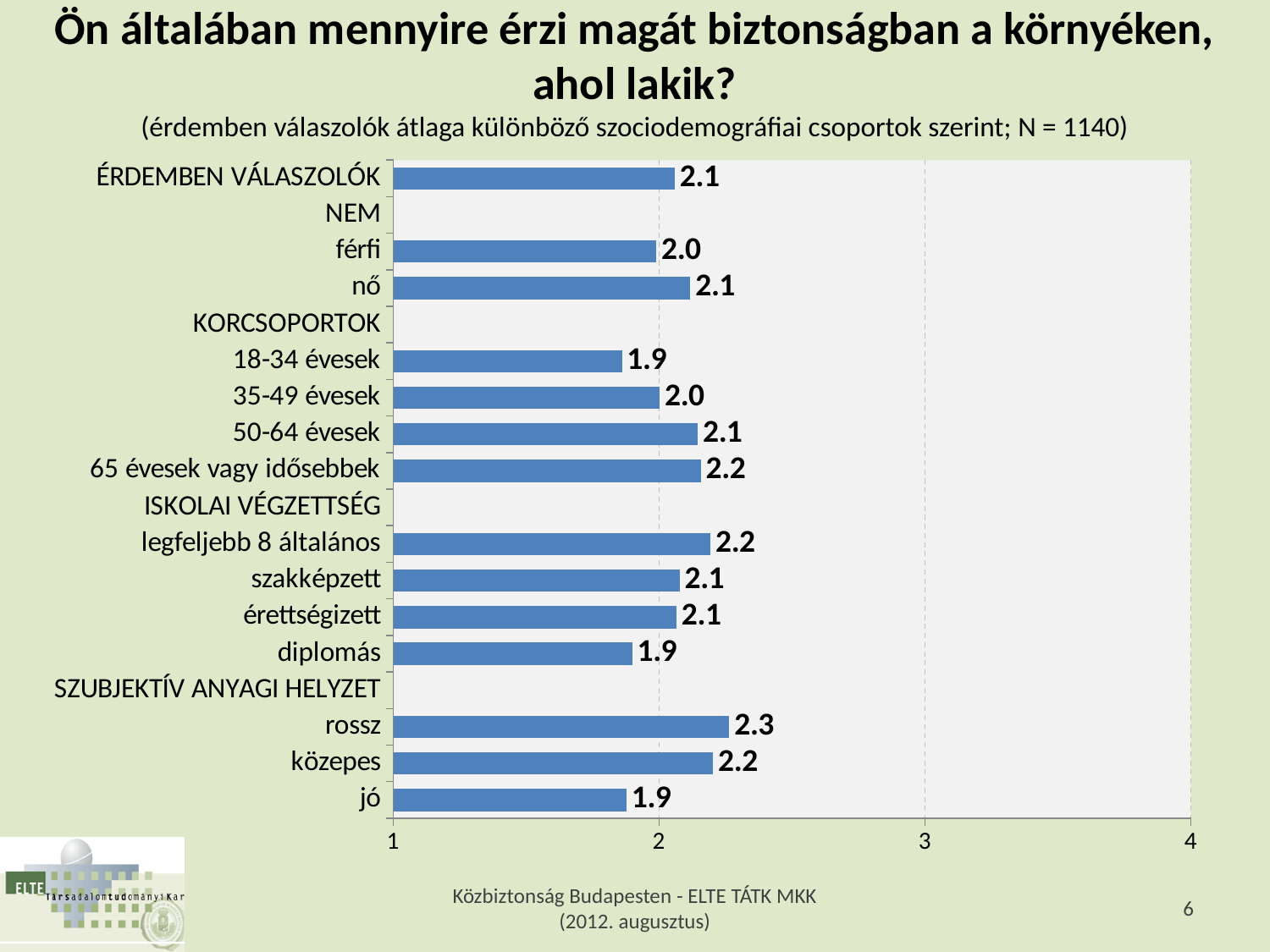
What is the value for 'férfi'? 2.0 What is the maximum value shown on the horizontal axis? 4 How many bars are plotted in the chart? 14 Is the value for 'rossz' greater or less than 2? greater What is the value for 'legfeljebb 8 általános'? 2.2 Which has a larger value, 'férfi' or 'nő'? nő What is the value for '18-34 évesek'? 1.9 Which category has the highest value? rossz What is the difference between the values for 'rossz' and 'jó'? 0.4 What kind of chart is shown on the slide? bar chart What is the value for 'ÉRDEMBEN VÁLASZOLÓK'? 2.1 What is the value for 'rossz'? 2.3